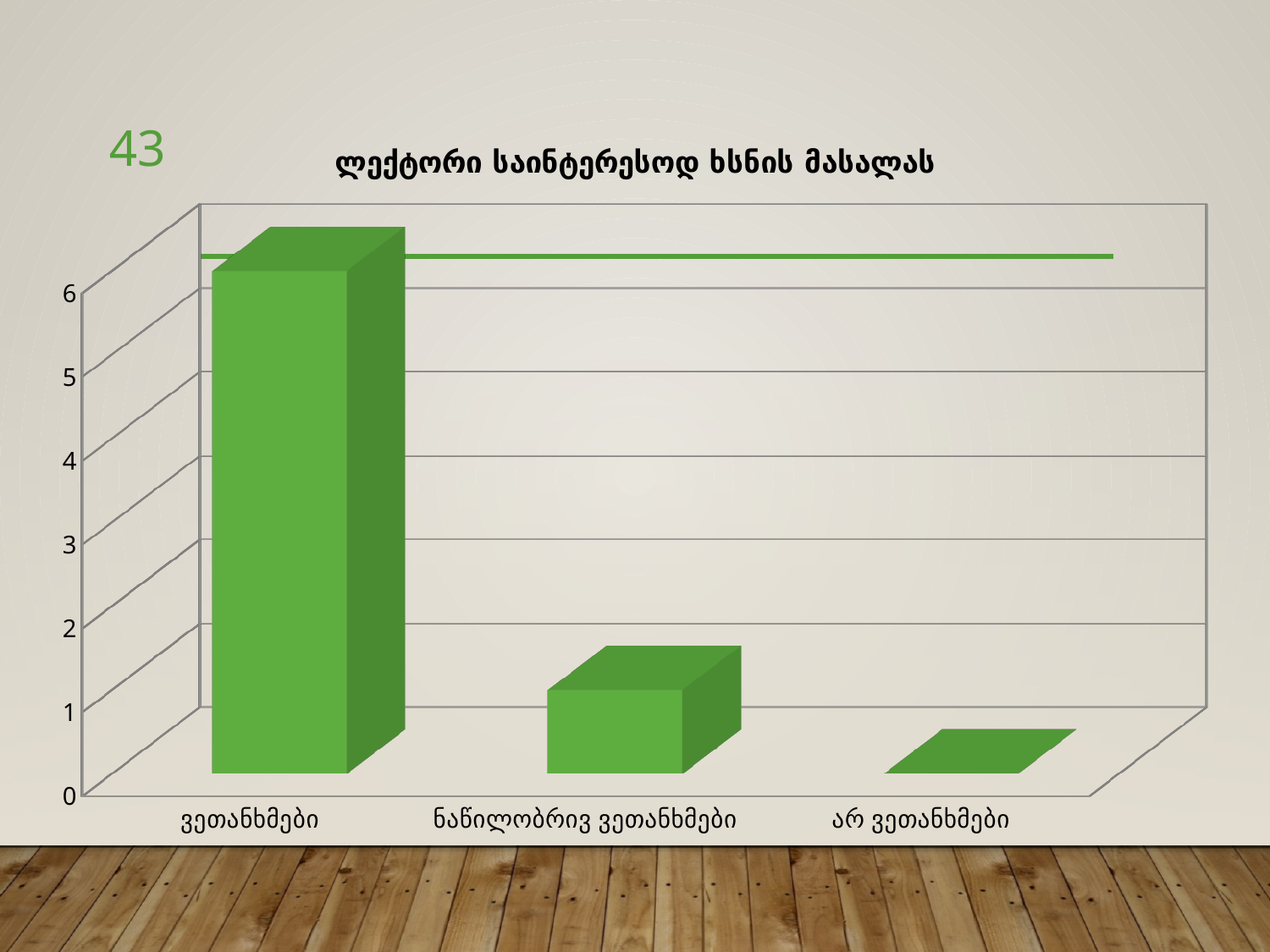
Is the value for ნაწილობრივ ვეთანხმები greater or less than 3? less What is the title of the chart? ლექტორი საინტერესოდ ხსნის მასალას Which category has the lowest value? არ ვეთანხმები Is the value for არ ვეთანხმები greater or less than 1? less What kind of chart is shown on the slide? bar chart What colour are the bars in the chart? green Which is larger, the value for ვეთანხმები or the value for ნაწილობრივ ვეთანხმები? ვეთანხმები Is the value for ვეთანხმები greater or less than 4? greater Which category has the highest value? ვეთანხმები Do the values rise or fall moving from left to right along the x axis? fall How many categories are shown on the x axis of the chart? 3 Which is larger, the value for ნაწილობრივ ვეთანხმები or the value for არ ვეთანხმები? ნაწილობრივ ვეთანხმები